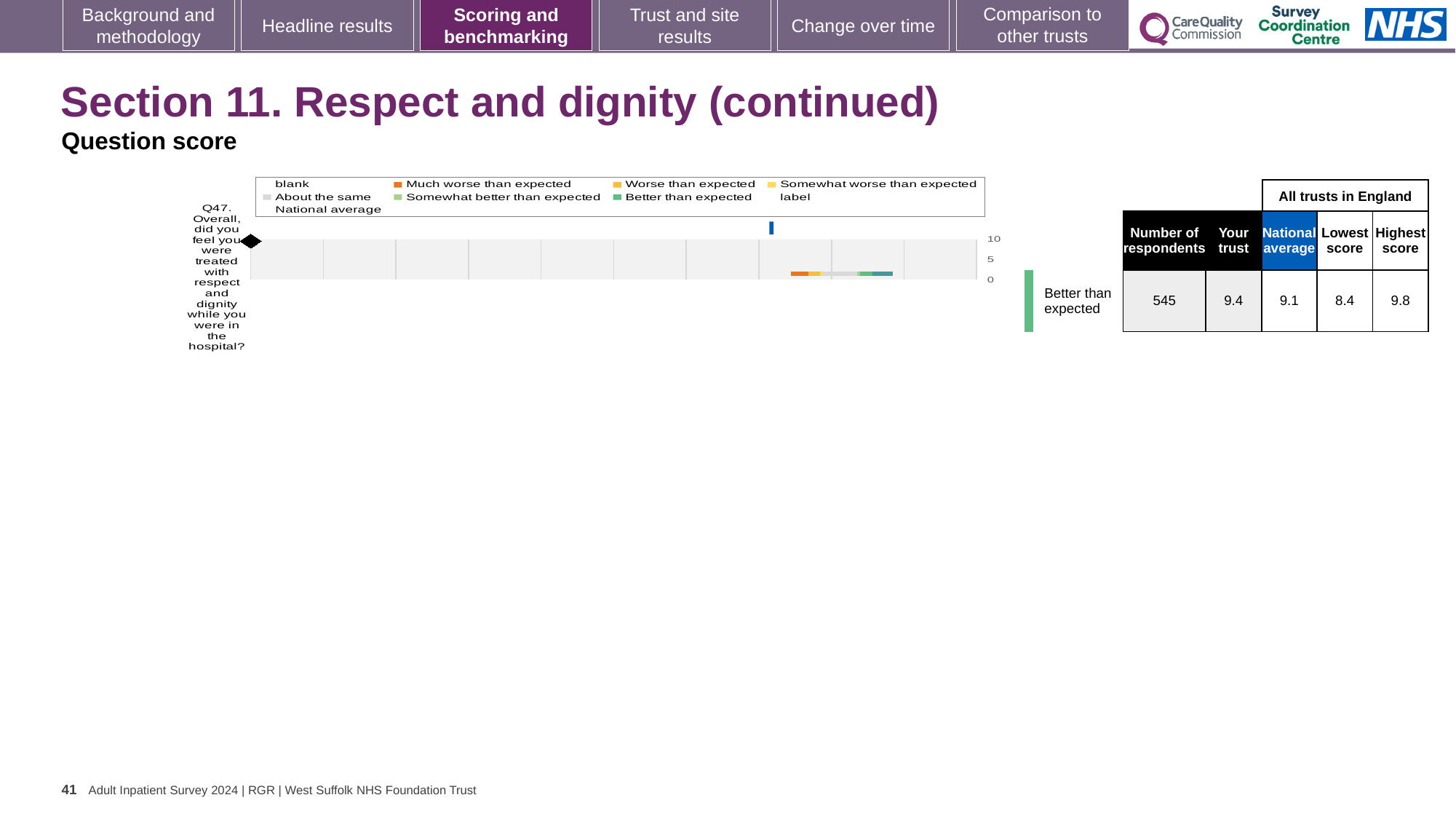
What benchmark rating is shown next to the chart for Q47? Better than expected Which question number is plotted on the chart? Q47 In the table beside the chart, what is the Highest score among all trusts in England? 9.8 How many question categories are plotted on the chart? 1 In the table beside the chart, what is the number of respondents for Q47? 545 Is the Your trust score larger or smaller than the National average score? larger What is the difference between the Your trust score and the National average score? 0.3 In the table beside the chart, what is the Lowest score among all trusts in England? 8.4 In the table beside the chart, what is the National average score? 9.1 What is the highest tick value shown on the chart's axis? 10 What kind of chart is shown on the slide? bar chart In the table beside the chart, what is the score for Your trust? 9.4